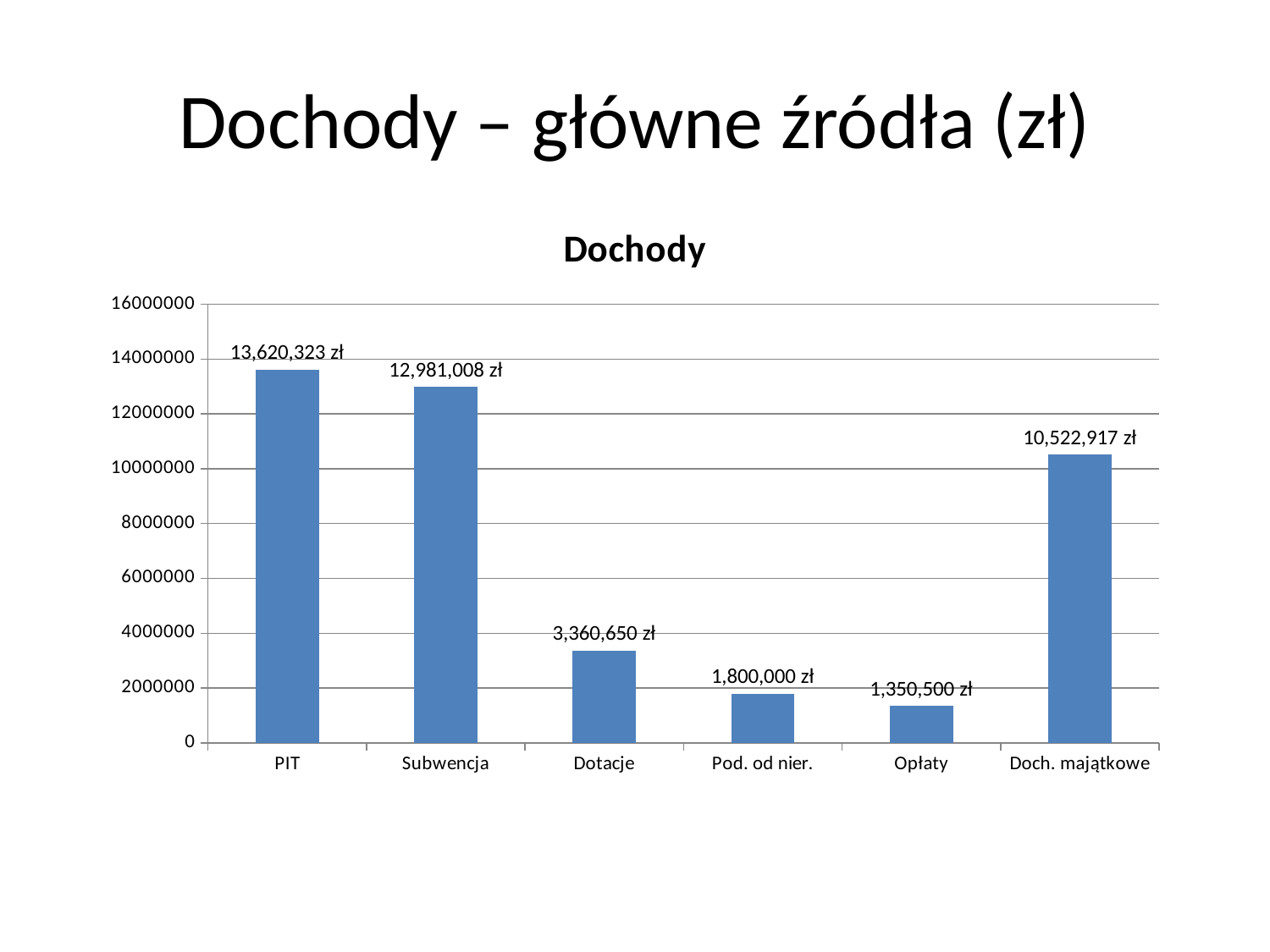
What is the title of the chart? Dochody Which category has the highest value? PIT Which is larger, Subwencja or Doch. majątkowe? Subwencja Which category has the lowest value? Opłaty What is the value for Dotacje? 3,360,650 zł What is the difference between Pod. od nier. and Opłaty? 449,500 zł What kind of chart is shown? bar chart Is the value for Dotacje greater or less than 4000000? less What is the value for Doch. majątkowe? 10,522,917 zł What is the difference between PIT and Subwencja? 639,315 zł How many categories are shown on the x axis? 6 What is the value for PIT? 13,620,323 zł